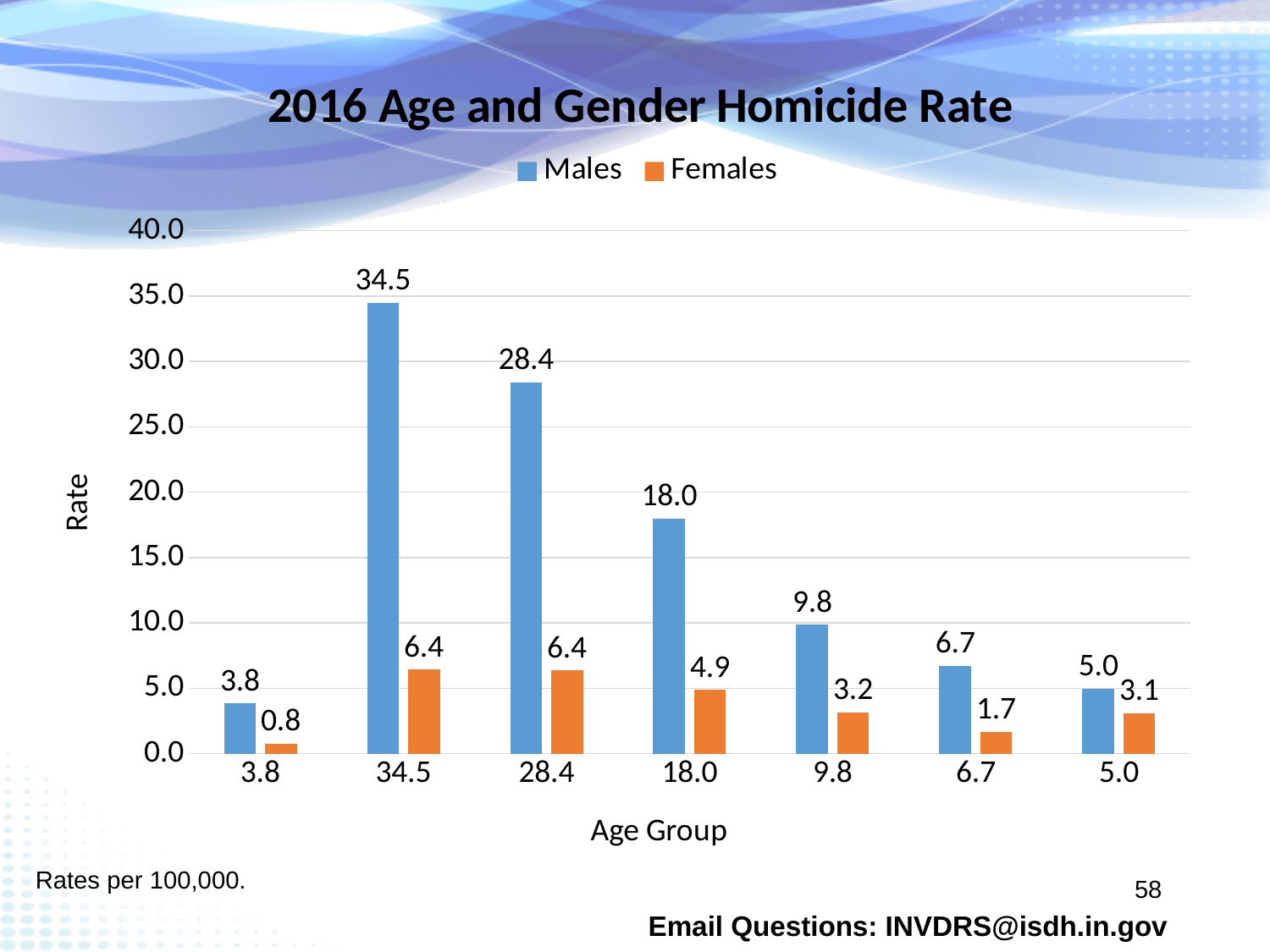
From the second age group onward, do the Males values rise or fall moving left to right along the x axis? fall Which is larger for the last age group on the right (x-axis label 5.0): the Males value or the Females value? Males How many series does the legend list? 2 What kind of chart is shown on the slide? bar chart What is the Females value for the second age group from the left (x-axis label 34.5)? 6.4 What is the difference between the Males and Females values for the third age group from the left (x-axis label 28.4)? 22.0 What is the title of the chart? 2016 Age and Gender Homicide Rate How many age-group categories are plotted along the x axis? 7 What is the Males value for the fourth age group from the left (x-axis label 18.0)? 18.0 What is the lowest Females value shown on the chart? 0.8 What is the Females value for the sixth age group from the left (x-axis label 6.7)? 1.7 What is the highest Males value shown on the chart? 34.5